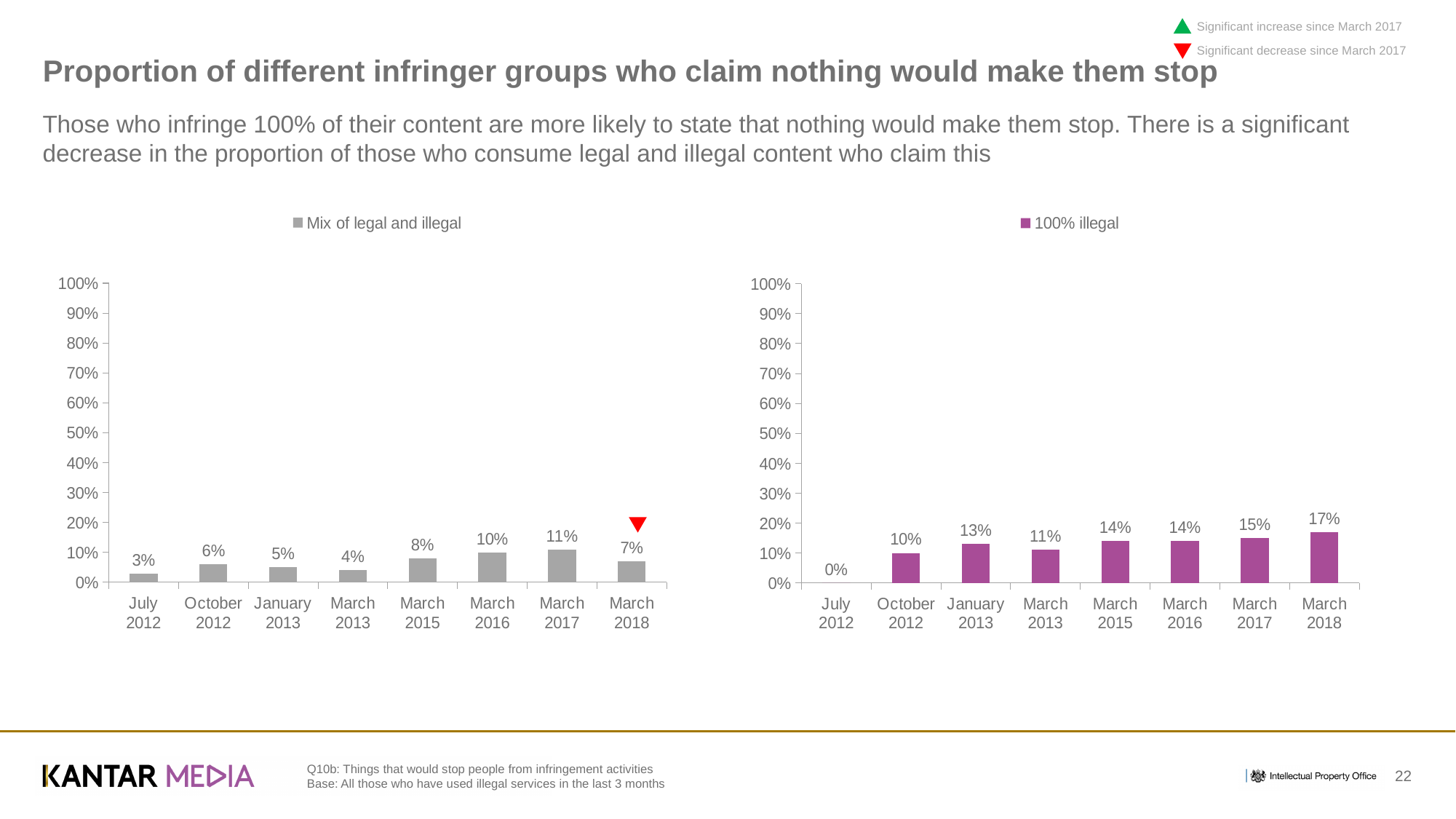
Which is larger: the March 2018 value in the '100% illegal' chart or the March 2018 value in the 'Mix of legal and illegal' chart? 100% illegal What colour are the bars in the '100% illegal' chart? Purple In the '100% illegal' chart, do the values generally rise or fall from July 2012 to March 2018? Rise In the 'Mix of legal and illegal' chart, is the value for March 2016 greater or less than 20%? less In the '100% illegal' chart, what is the difference between March 2018 and October 2012? 7% In the '100% illegal' chart, what is the value for March 2018? 17% In the 'Mix of legal and illegal' chart, what is the value for March 2018? 7% What type of chart is the 'Mix of legal and illegal' chart? Bar chart In the '100% illegal' chart, which period has the lowest value? July 2012 In the 'Mix of legal and illegal' chart, what is the difference between March 2017 and March 2018? 4% In the 'Mix of legal and illegal' chart, which period has the highest value? March 2017 How many periods are shown on the x axis of the '100% illegal' chart? 8